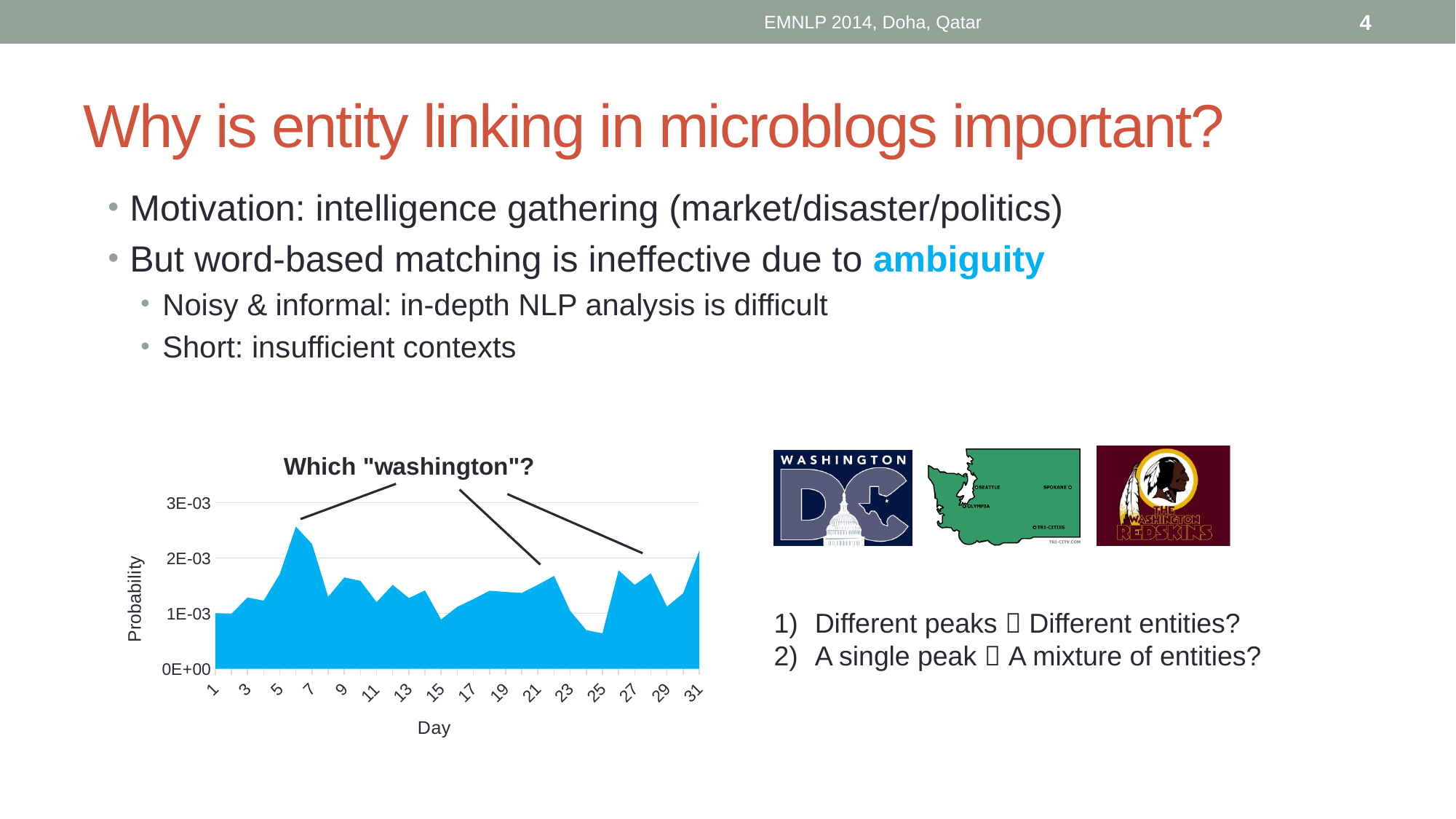
What kind of chart is shown on the slide? area chart On which day does the probability reach its highest value? 6 Is the probability on day 25 greater or less than 1E-03? less What is the label of the y axis of the chart? Probability Does the probability rise or fall from day 6 to day 10? fall What is the last day shown on the x axis? 31 Is the probability on day 22 greater or less than 1E-03? greater What is the title of the chart? Which "washington"? Which day has the higher probability, day 6 or day 25? day 6 Is the probability on day 1 greater or less than 2E-03? less What is the highest tick value shown on the y axis? 3E-03